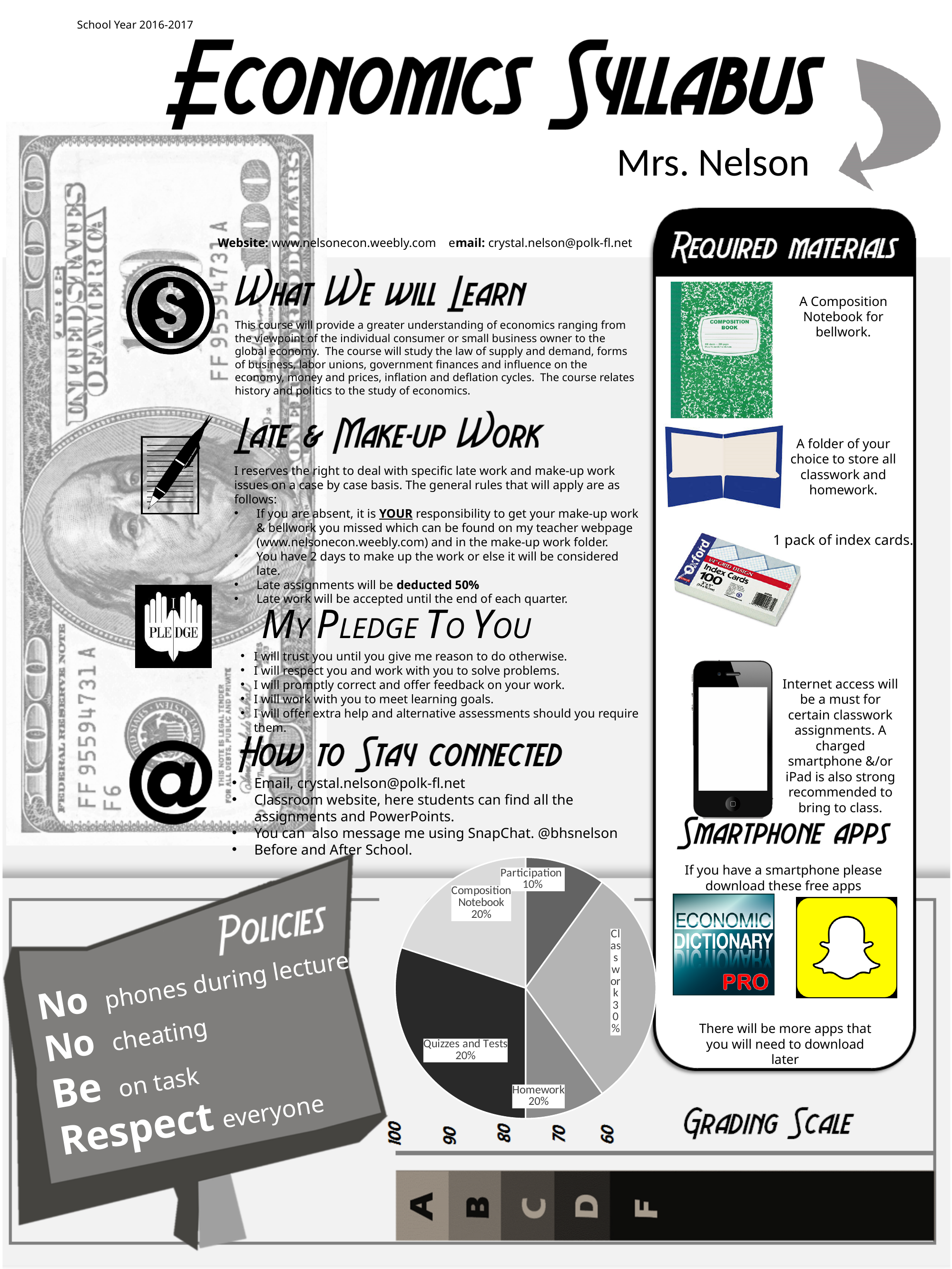
In the pie chart, what share does Homework have? 20% Which slice of the pie chart is the largest? Classwork In the pie chart, what is the difference between the Classwork share and the Participation share? 20% Which slice of the pie chart is the smallest? Participation In the pie chart, what is the combined share of Homework and Quizzes and Tests? 40% In the pie chart, what share does Participation have? 10% In the pie chart, which is larger: Classwork or Homework? Classwork What kind of chart is shown at the bottom centre of the slide? pie chart In the pie chart, what share does Quizzes and Tests have? 20% How many slices does the pie chart have? 5 In the pie chart, what share does Classwork have? 30% In the pie chart, what share does Composition Notebook have? 20%